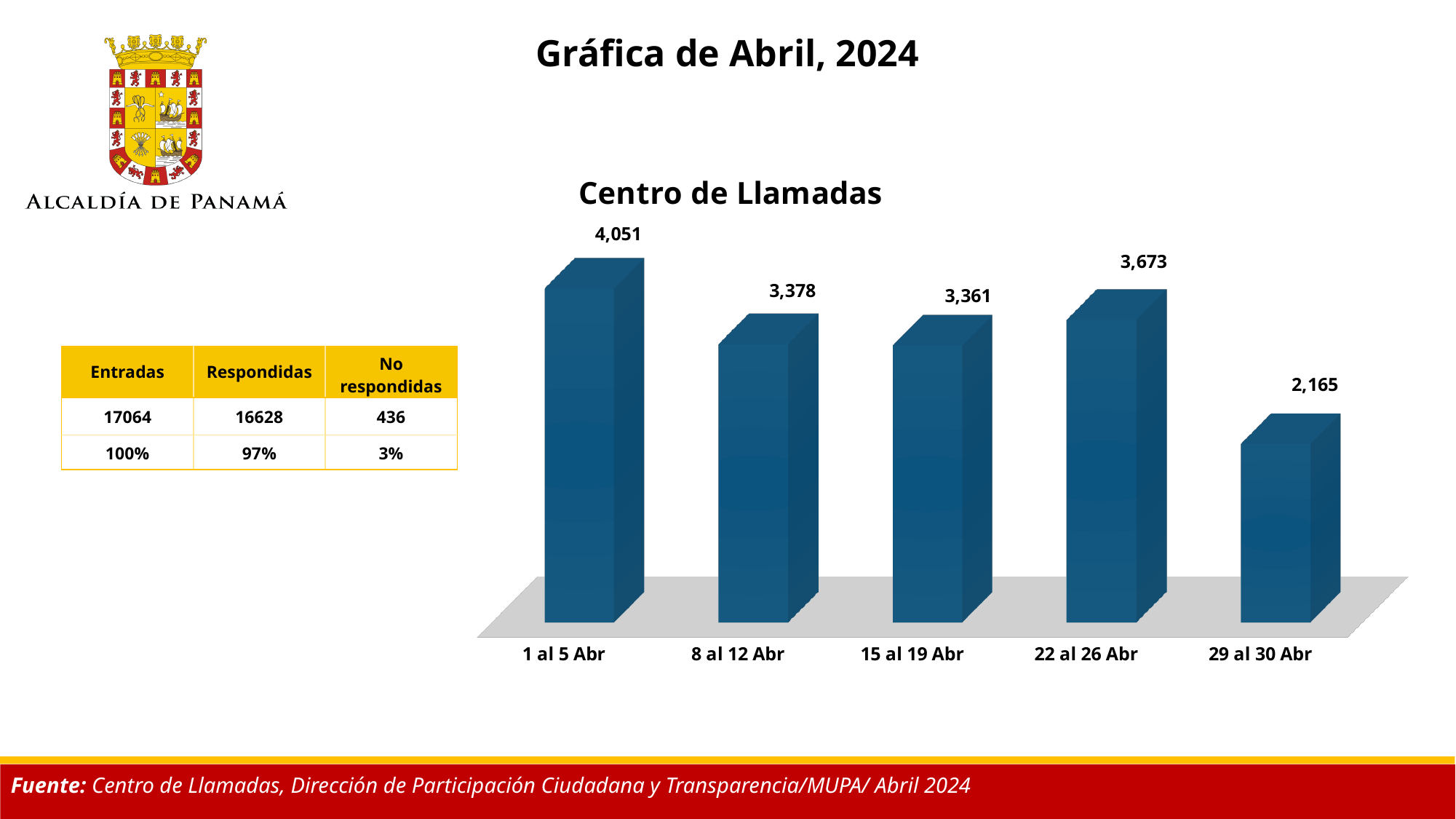
What kind of chart is shown? Bar chart What is the value for 1 al 5 Abr? 4,051 What is the value for 15 al 19 Abr? 3,361 Which period has the lowest value? 29 al 30 Abr Which is larger, the value for 22 al 26 Abr or the value for 8 al 12 Abr? 22 al 26 Abr What is the difference between the values for 22 al 26 Abr and 8 al 12 Abr? 295 What is the value for 8 al 12 Abr? 3,378 What is the difference between the values for 1 al 5 Abr and 29 al 30 Abr? 1,886 What is the value for 22 al 26 Abr? 3,673 Which period has the highest value? 1 al 5 Abr How many periods are shown on the chart? 5 What is the value for 29 al 30 Abr? 2,165